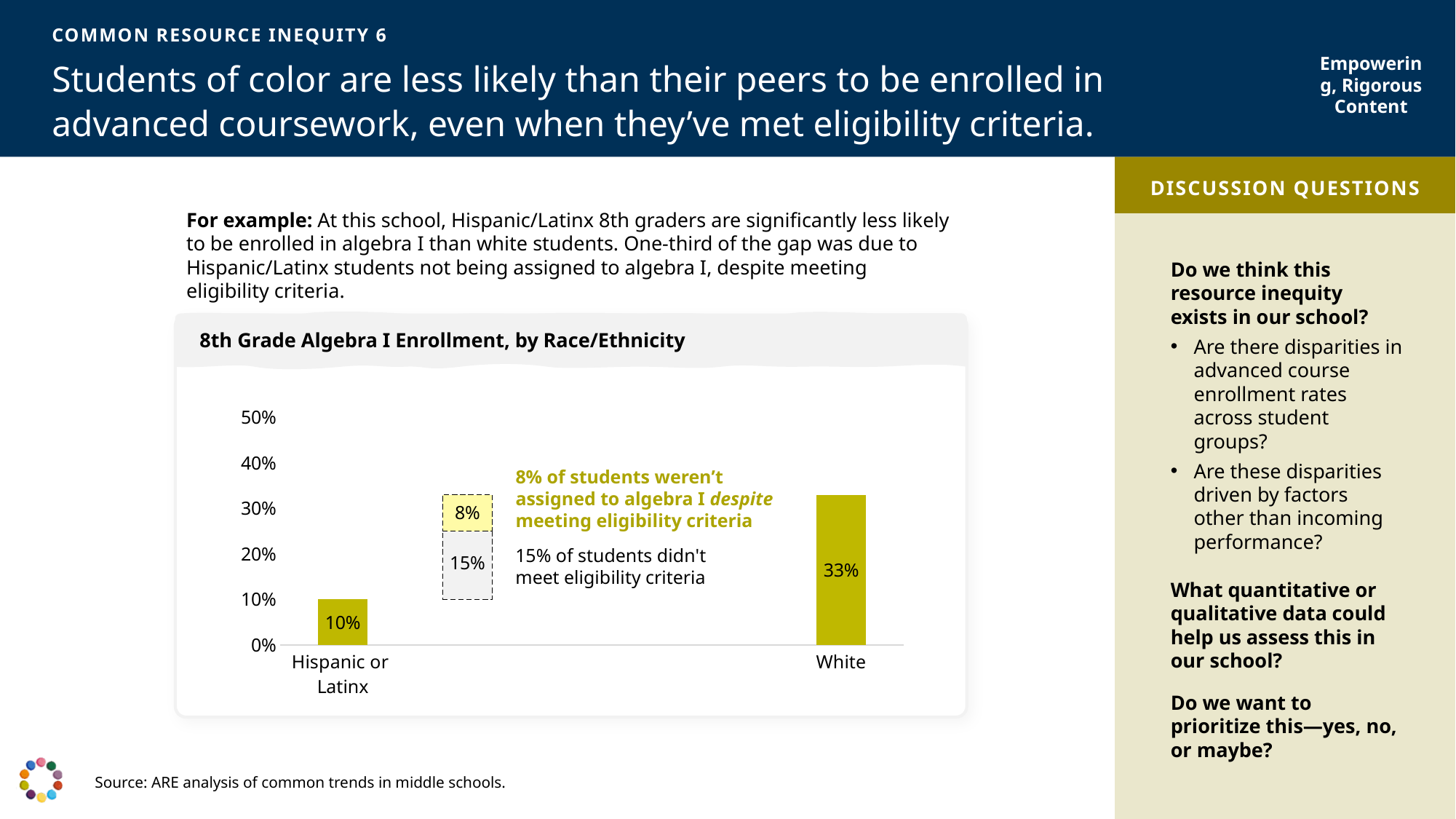
Is the enrollment rate for Hispanic or Latinx students greater or less than 20%? less What type of chart is used to show 8th grade algebra I enrollment by race/ethnicity? Bar chart What percentage of students weren't assigned to algebra I despite meeting eligibility criteria, according to the chart annotation? 8% How many race/ethnicity groups are plotted as bars in the chart? 2 What percentage of students didn't meet eligibility criteria, according to the chart annotation? 15% Which group has the higher algebra I enrollment rate, Hispanic or Latinx or White? White What is the 8th grade algebra I enrollment rate for Hispanic or Latinx students? 10% What is the 8th grade algebra I enrollment rate for White students? 33% What is the title of the chart? 8th Grade Algebra I Enrollment, by Race/Ethnicity What is the difference in algebra I enrollment rate between White and Hispanic or Latinx students? 23% Is the enrollment rate for White students greater or less than 30%? greater Which group has the lowest algebra I enrollment rate shown in the chart? Hispanic or Latinx